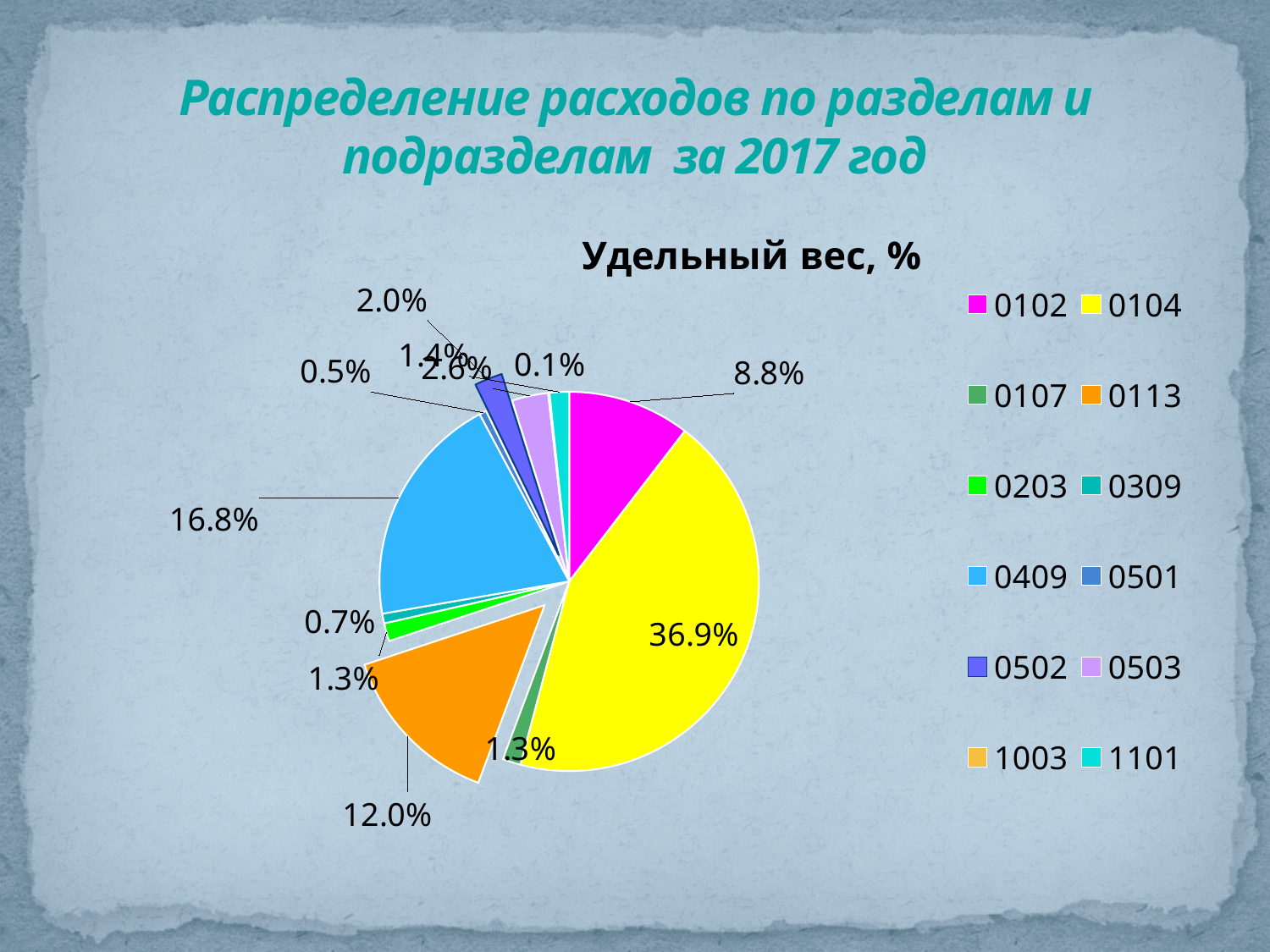
What kind of chart is shown on the slide? pie chart What is the share for category 0102? 8.8% What is the share for category 0409? 16.8% What is the difference between the shares for 0104 and 0409? 20.1% What is the share for category 0104? 36.9% How many entries does the chart legend list? 12 What is the smallest percentage label shown on the pie? 0.1% What is the share for category 0113? 12.0% Which category has the largest slice of the pie? 0104 What is the title of the chart? Удельный вес, % What is the share for category 0309? 0.7% Which is larger, the share for 0409 or the share for 0113? 0409